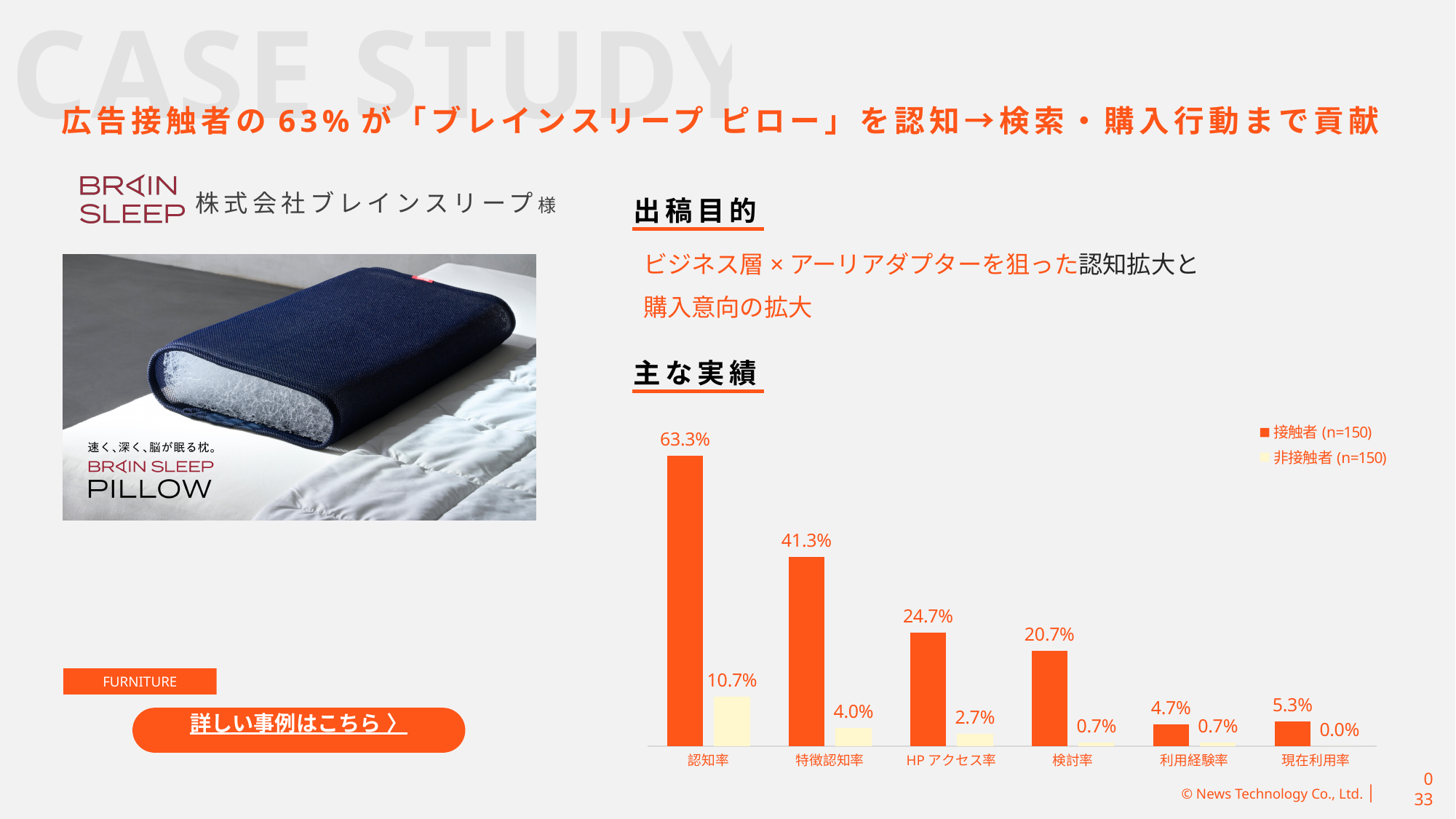
What is the value for 非接触者 (n=150) in the 現在利用率 category? 0.0% What is the value for 接触者 (n=150) in the 検討率 category? 20.7% What is the difference between the 接触者 (n=150) and 非接触者 (n=150) values in the 特徴認知率 category? 37.3% What are the two series names listed in the chart legend? 接触者 (n=150) and 非接触者 (n=150) What kind of chart is shown on the slide? Bar chart What is the value for 接触者 (n=150) in the 認知率 category? 63.3% What is the value for 非接触者 (n=150) in the 認知率 category? 10.7% Which is larger for 接触者 (n=150): 利用経験率 or 現在利用率? 現在利用率 Which category has the highest value for 接触者 (n=150)? 認知率 Which category has the lowest value for 非接触者 (n=150)? 現在利用率 How many categories are shown on the x axis of the chart? 6 How many series does the chart legend list? 2